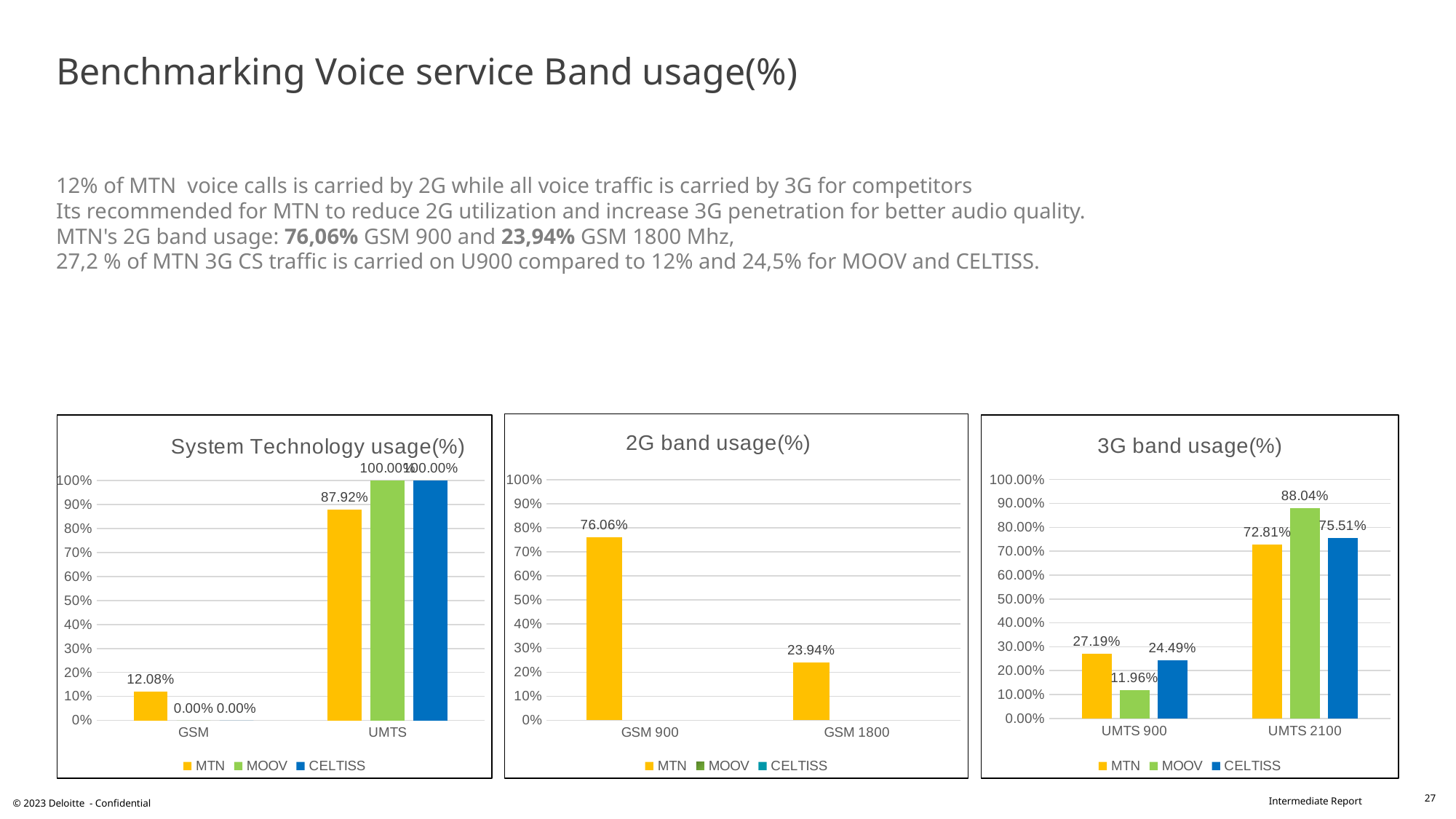
In the 'System Technology usage(%)' chart, what is the difference between MTN's UMTS value and its GSM value? 75.84% In the '3G band usage(%)' chart, what is the difference between MOOV's and MTN's values under UMTS 2100? 15.23% In the '3G band usage(%)' chart, which operator has the lowest value under UMTS 900? MOOV In the 'System Technology usage(%)' chart, what is the value for MOOV under UMTS? 100.00% In the '3G band usage(%)' chart, which operator has the highest value under UMTS 2100? MOOV In the 'System Technology usage(%)' chart, what is the value for MTN under UMTS? 87.92% In the '3G band usage(%)' chart, what is the value for CELTISS under UMTS 900? 24.49% How many series does the legend of the '3G band usage(%)' chart list? 3 In the '2G band usage(%)' chart, what is the value for MTN under GSM 900? 76.06% In the '2G band usage(%)' chart, what is the value for MTN under GSM 1800? 23.94% In the '2G band usage(%)' chart, which category has the higher MTN value, GSM 900 or GSM 1800? GSM 900 In the 'System Technology usage(%)' chart, what is the value for MTN under GSM? 12.08%